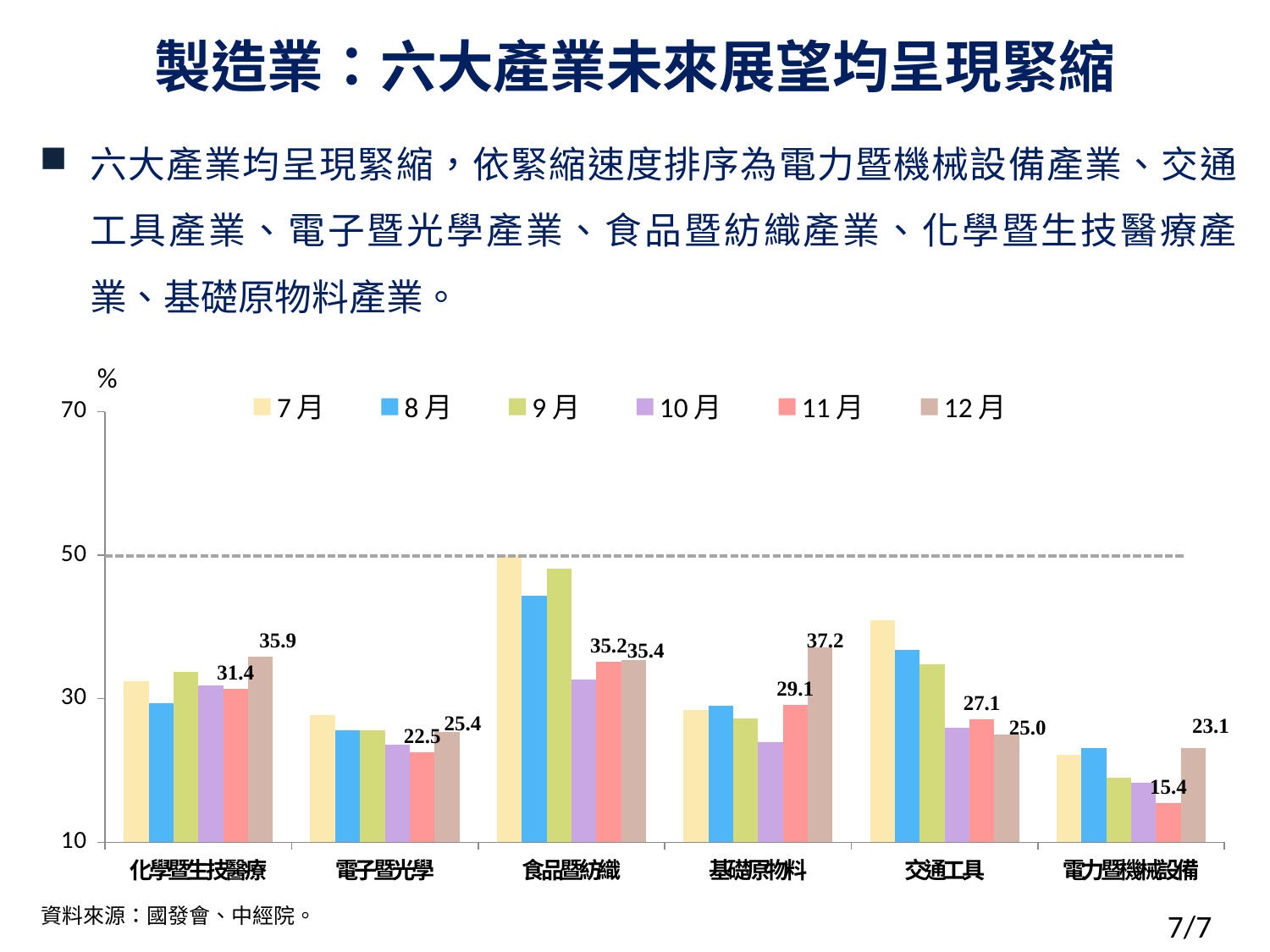
Which industry has the lowest 11月 value? 電力暨機械設備 What is the 11月 value for 交通工具? 27.1 Is the 7月 value for 食品暨紡織 greater or less than 30? greater How many industry categories are shown on the x axis? 6 Which industry has the highest 12月 value? 基礎原物料 How many series does the legend list? 6 What is the 11月 value for 電力暨機械設備? 15.4 Which is larger for 交通工具: the 11月 value or the 12月 value? 11月 What is the 12月 value for 化學暨生技醫療? 35.9 What type of chart is shown on the slide? bar chart What is the 12月 value for 基礎原物料? 37.2 What is the difference between the 12月 and 11月 values for 基礎原物料? 8.1